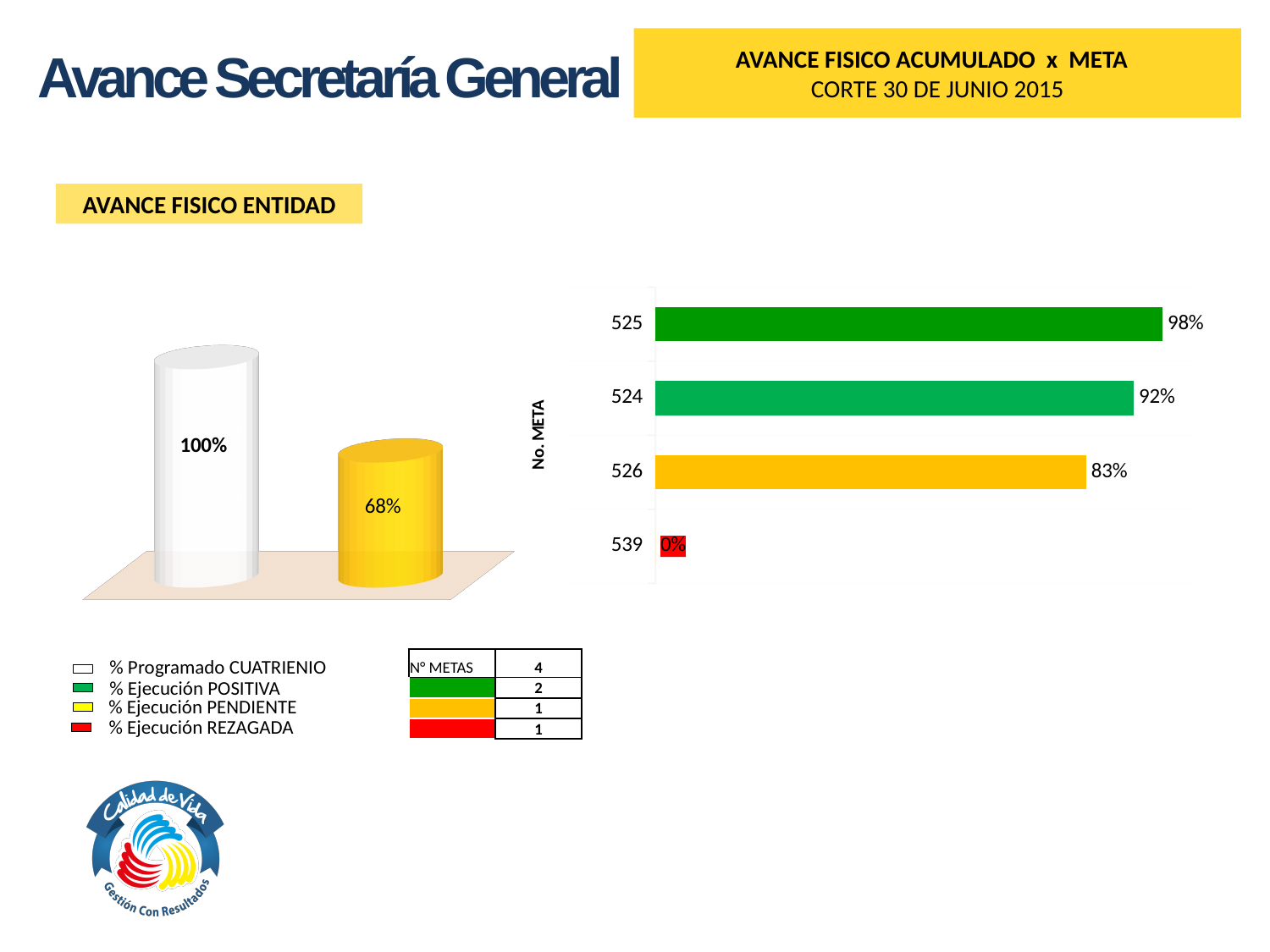
In the AVANCE FISICO ACUMULADO x META chart, what is the value for meta 539? 0% In the AVANCE FISICO ACUMULADO x META chart, which meta has the highest value? 525 In the AVANCE FISICO ACUMULADO x META chart, which meta has the lowest value? 539 In the AVANCE FISICO ACUMULADO x META chart, what is the value for meta 526? 83% In the AVANCE FISICO ACUMULADO x META chart, how many metas are shown? 4 In the AVANCE FISICO ENTIDAD chart, what is the difference between the white bar and the yellow bar? 32% In the AVANCE FISICO ENTIDAD chart, what is the value of the white bar (% Programado CUATRIENIO)? 100% What kind of chart is the AVANCE FISICO ACUMULADO x META chart? Bar chart In the AVANCE FISICO ACUMULADO x META chart, what is the value for meta 525? 98% In the AVANCE FISICO ENTIDAD chart, what is the value of the yellow bar (% Ejecución PENDIENTE)? 68% In the AVANCE FISICO ACUMULADO x META chart, what is the value for meta 524? 92% In the AVANCE FISICO ACUMULADO x META chart, what is the difference between the values for meta 525 and meta 526? 15%